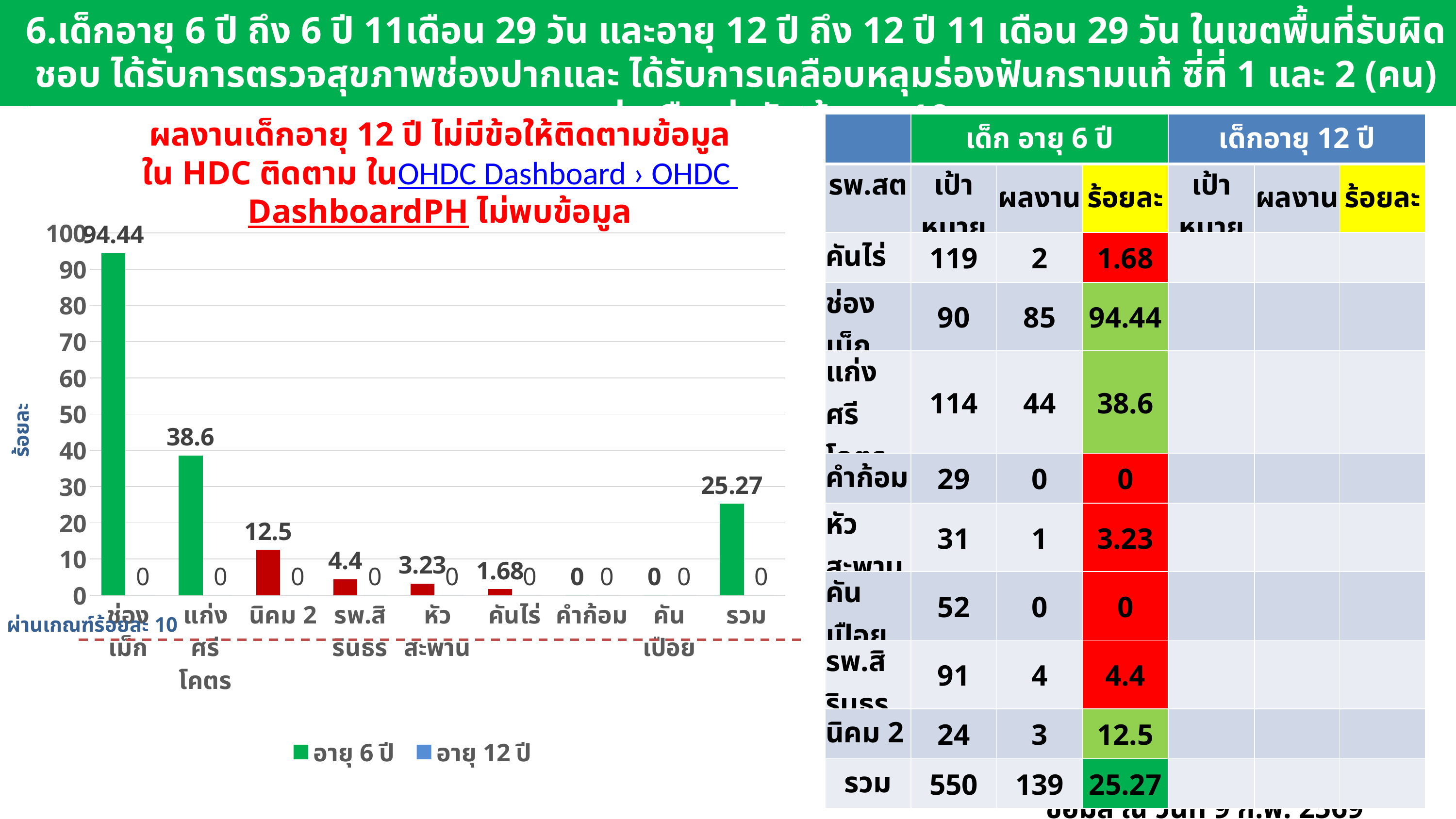
Which category has the highest value in the อายุ 6 ปี series? ช่องเม็ก What is the value for ช่องเม็ก in the อายุ 6 ปี series? 94.44 What is the value for รวม in the อายุ 6 ปี series? 25.27 What is the value for คันไร่ in the อายุ 6 ปี series? 1.68 What is the difference between the อายุ 6 ปี values for ช่องเม็ก and แก่งศรีโคตร? 55.84 What kind of chart is shown on the slide? bar chart Which is larger in the อายุ 6 ปี series: นิคม 2 or รพ.สิรินธร? นิคม 2 What is the value for แก่งศรีโคตร in the อายุ 6 ปี series? 38.6 Is the อายุ 6 ปี value for หัวสะพาน greater or less than 10? less How many categories are shown on the x axis of the chart? 9 How many series does the chart legend list? 2 What is the value for คำก้อม in the อายุ 12 ปี series? 0